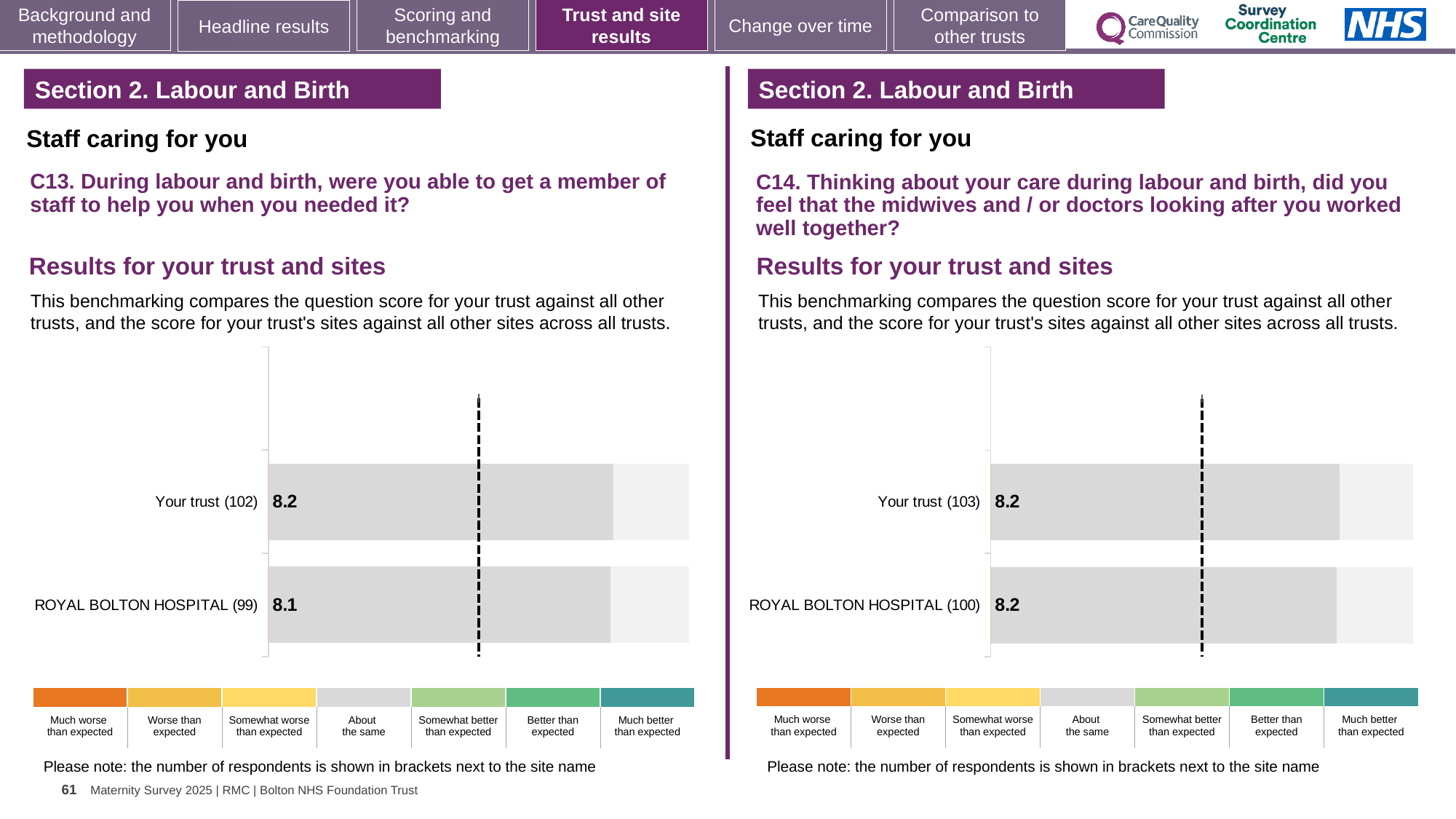
In the C14 chart on the right, what is the score for ROYAL BOLTON HOSPITAL? 8.2 How many bars are plotted in the C13 chart on the left? 2 In the C13 chart on the left, what is the score for Your trust? 8.2 In the C14 chart on the right, what is the difference between the Your trust score and the ROYAL BOLTON HOSPITAL score? 0 In the C13 chart on the left, which has the higher score, Your trust or ROYAL BOLTON HOSPITAL? Your trust How many bars are plotted in the C14 chart on the right? 2 In the C13 chart on the left, what is the score for ROYAL BOLTON HOSPITAL? 8.1 In the C13 chart on the left, how many respondents are shown in brackets for ROYAL BOLTON HOSPITAL? 99 What type of chart is used for the C13 results on the left? Bar chart In the C14 chart on the right, how many respondents are shown in brackets for Your trust? 103 In the C14 chart on the right, what is the score for Your trust? 8.2 In the C13 chart on the left, what is the difference between the Your trust score and the ROYAL BOLTON HOSPITAL score? 0.1